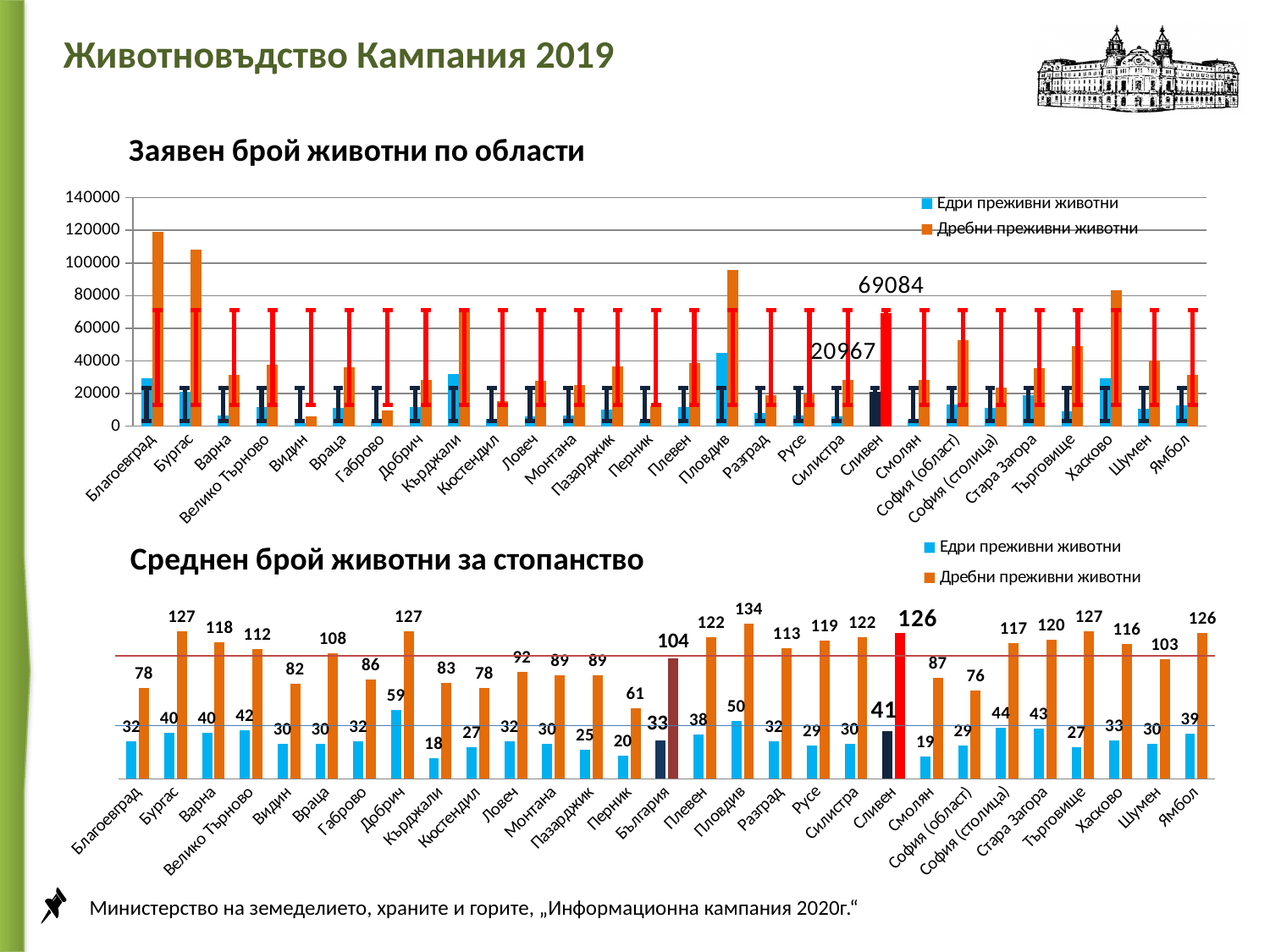
In the chart 'Заявен брой животни по области', which region has the highest value for Дребни преживни животни? Благоевград What type of chart is 'Среднен брой животни за стопанство'? bar chart In the chart 'Среднен брой животни за стопанство', what is the value for Дребни преживни животни in Пловдив? 134 In the chart 'Среднен брой животни за стопанство', which category has the lowest value for Едри преживни животни? Кърджали In the chart 'Заявен брой животни по области', what is the value labelled for Дребни преживни животни in Сливен? 69084 In the chart 'Среднен брой животни за стопанство', which is larger: the Едри преживни животни value for Сливен or for Смолян? Сливен In the chart 'Заявен брой животни по области', is the value for Дребни преживни животни in Благоевград greater or less than 100000? greater In the chart 'Заявен брой животни по области', how many series does the legend list? 2 In the chart 'Заявен брой животни по области', what is the value labelled for Едри преживни животни in Сливен? 20967 In the chart 'Среднен брой животни за стопанство', what is the difference between the Дребни преживни животни values for Бургас and Благоевград? 49 In the chart 'Среднен брой животни за стопанство', which category has the lowest value for Дребни преживни животни? Перник In the chart 'Среднен брой животни за стопанство', what is the value for Едри преживни животни in Добрич? 59